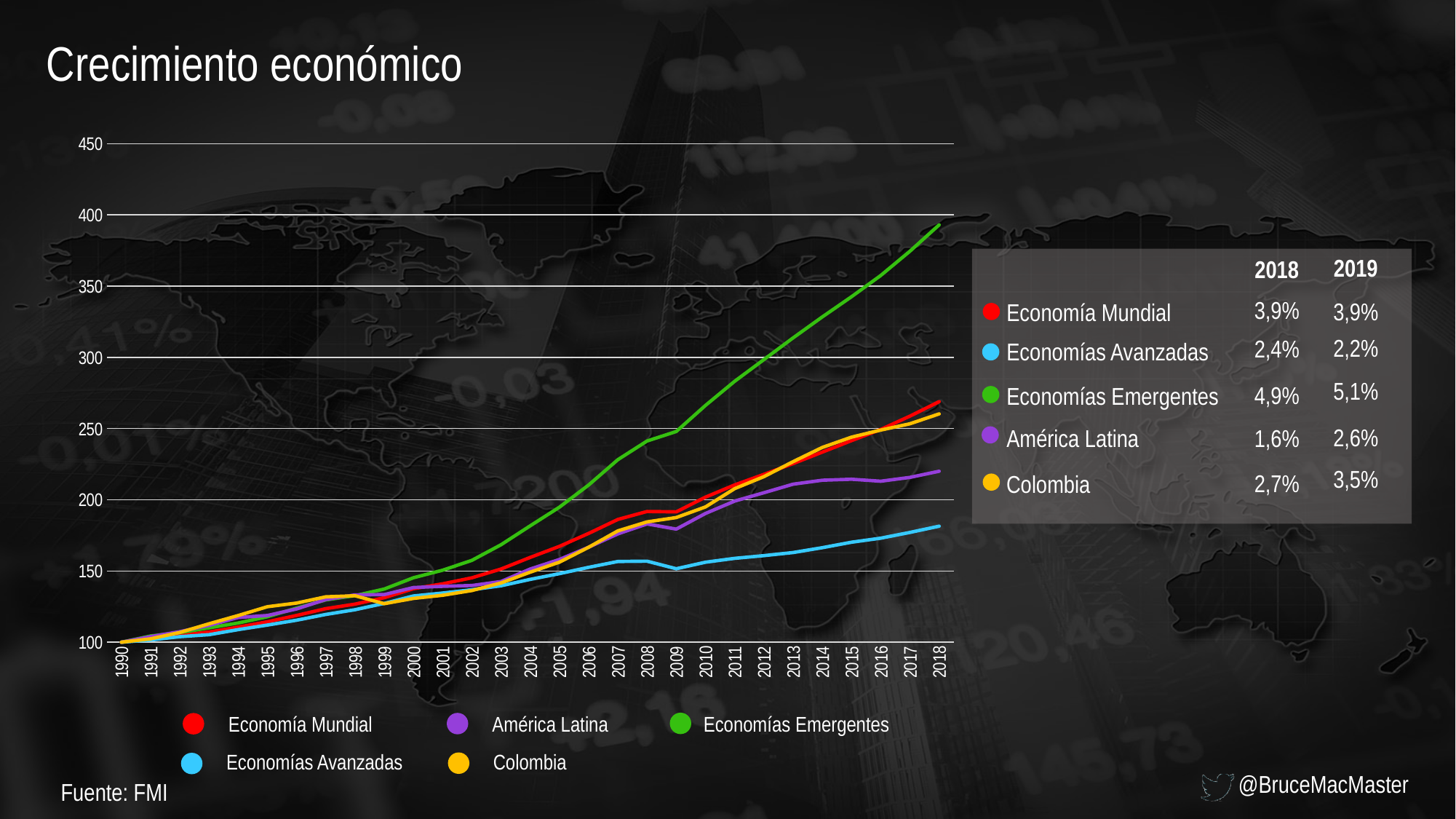
Which series has the highest value in 2018? Economías Emergentes What kind of chart is shown on the slide? line chart What is the title of the chart? Crecimiento económico In 2018, which is larger: Economía Mundial or América Latina? Economía Mundial What source is cited for the chart? FMI Is the value for América Latina in 2018 greater or less than 200? greater Is the value for Economías Emergentes in 2018 greater or less than 350? greater How many years are plotted along the x axis of the chart? 29 Do the values for Economías Emergentes rise or fall from 1990 to 2018? rise How many series does the chart legend list? 5 Is the value for Economías Avanzadas in 2018 greater or less than 200? less Which series has the lowest value in 2018? Economías Avanzadas